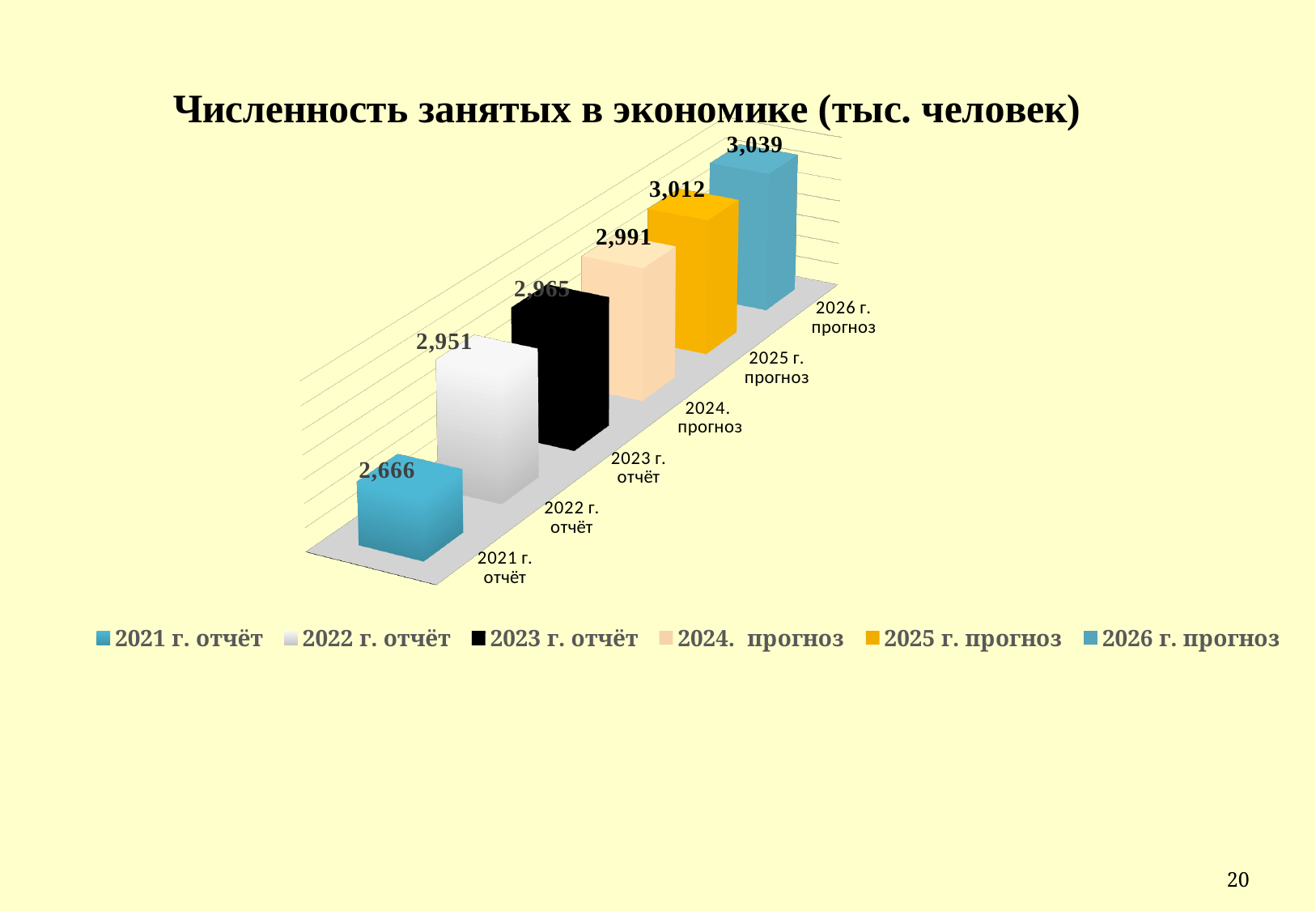
Which is larger, the value for 2022 г. отчёт or the value for 2025 г. прогноз? 2025 г. прогноз What kind of chart is shown on the slide? Bar chart What is the value for 2024. прогноз? 2,991 Do the values rise or fall from 2021 г. отчёт to 2026 г. прогноз? Rise What is the value for 2026 г. прогноз? 3,039 What is the difference between the values for 2026 г. прогноз and 2021 г. отчёт? 373 What is the value for 2021 г. отчёт? 2,666 Which category has the highest value? 2026 г. прогноз What is the difference between the values for 2025 г. прогноз and 2024. прогноз? 21 Which category has the lowest value? 2021 г. отчёт What is the value for 2023 г. отчёт? 2,965 How many categories are shown in the chart? 6